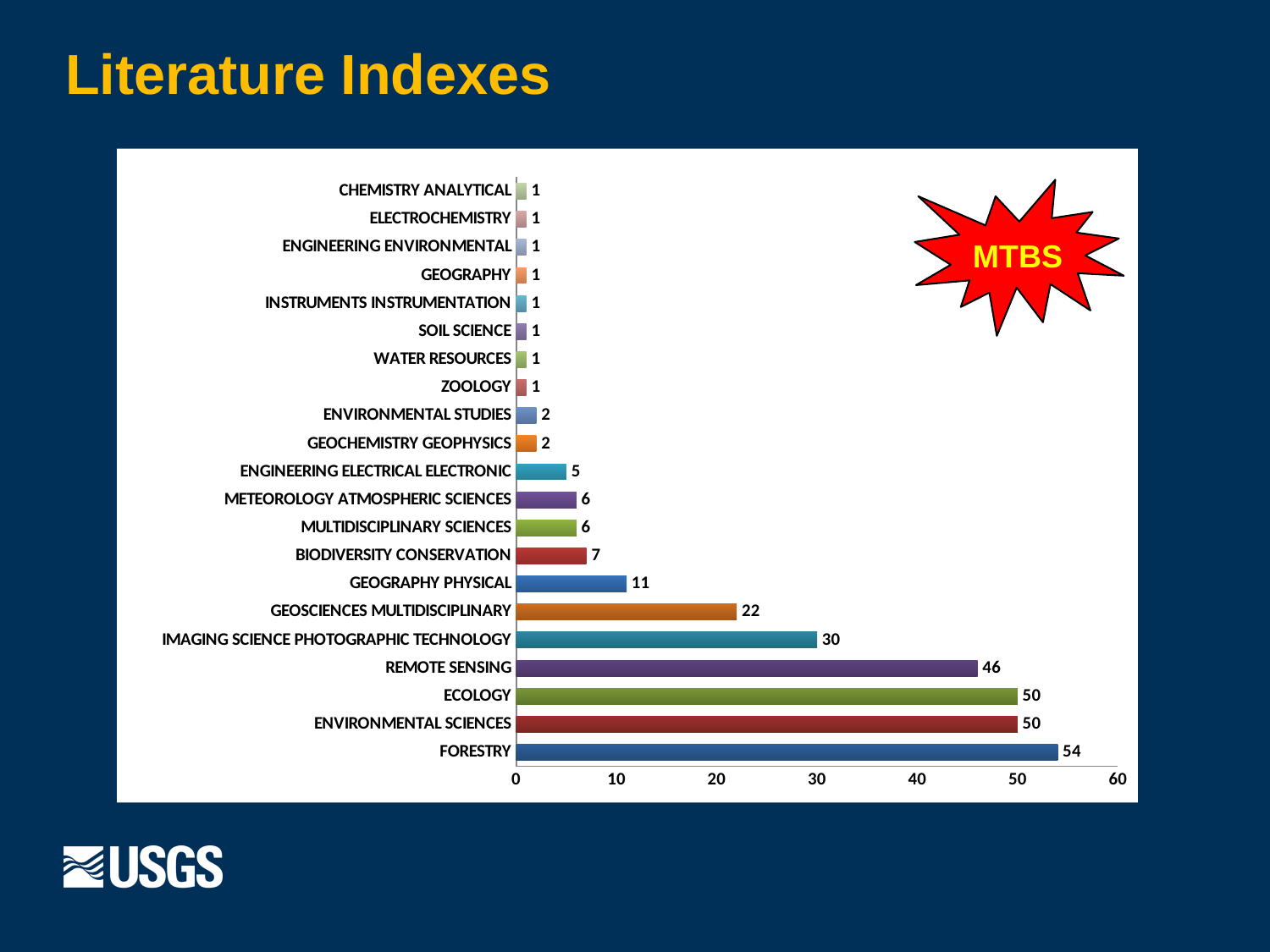
What is the value for GEOSCIENCES MULTIDISCIPLINARY? 22 Is the value for IMAGING SCIENCE PHOTOGRAPHIC TECHNOLOGY greater or less than 20? greater How many categories are shown in the chart? 21 What is the value for FORESTRY? 54 What kind of chart is shown on the slide? bar chart What is the difference between the values for IMAGING SCIENCE PHOTOGRAPHIC TECHNOLOGY and GEOGRAPHY PHYSICAL? 19 What is the title of the slide? Literature Indexes What is the difference between the values for FORESTRY and REMOTE SENSING? 8 What is the value for BIODIVERSITY CONSERVATION? 7 Which category has the highest value? FORESTRY What is the value for REMOTE SENSING? 46 Which is larger, the value for ECOLOGY or the value for REMOTE SENSING? ECOLOGY